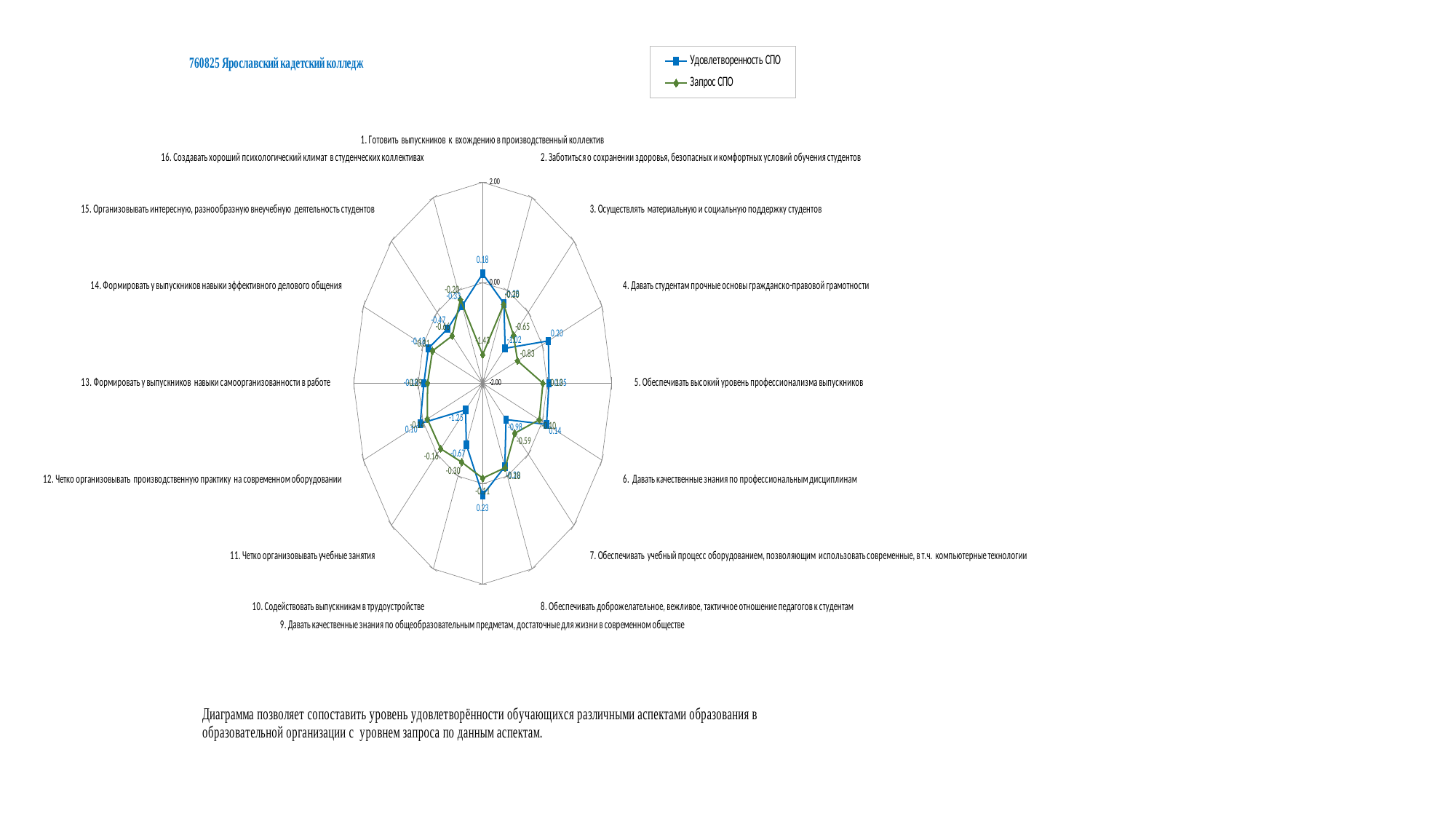
What is the Удовлетворенность СПО value for category 9 (Давать качественные знания по общеобразовательным предметам)? 0.23 Is the Удовлетворенность СПО value for category 3 (Осуществлять материальную и социальную поддержку студентов) greater or less than 0.00? less What are the two series named in the legend? Удовлетворенность СПО and Запрос СПО What is the maximum value shown on the radar chart's axis scale? 2.00 What is the Удовлетворенность СПО value for category 4 (Давать студентам прочные основы гражданско-правовой грамотности)? 0.20 How many categories (axes) does the radar chart have? 16 Which is larger for Удовлетворенность СПО: category 1 (0.18) or category 9 (0.23)? Category 9 What is the Удовлетворенность СПО value for category 1 (Готовить выпускников к вхождению в производственный коллектив)? 0.18 How many series does the legend list? 2 What kind of chart is shown on the slide? Radar chart What is the difference between the Удовлетворенность СПО values for category 9 (0.23) and category 1 (0.18)? 0.05 Is the Удовлетворенность СПО value for category 1 greater or less than 0.00? greater